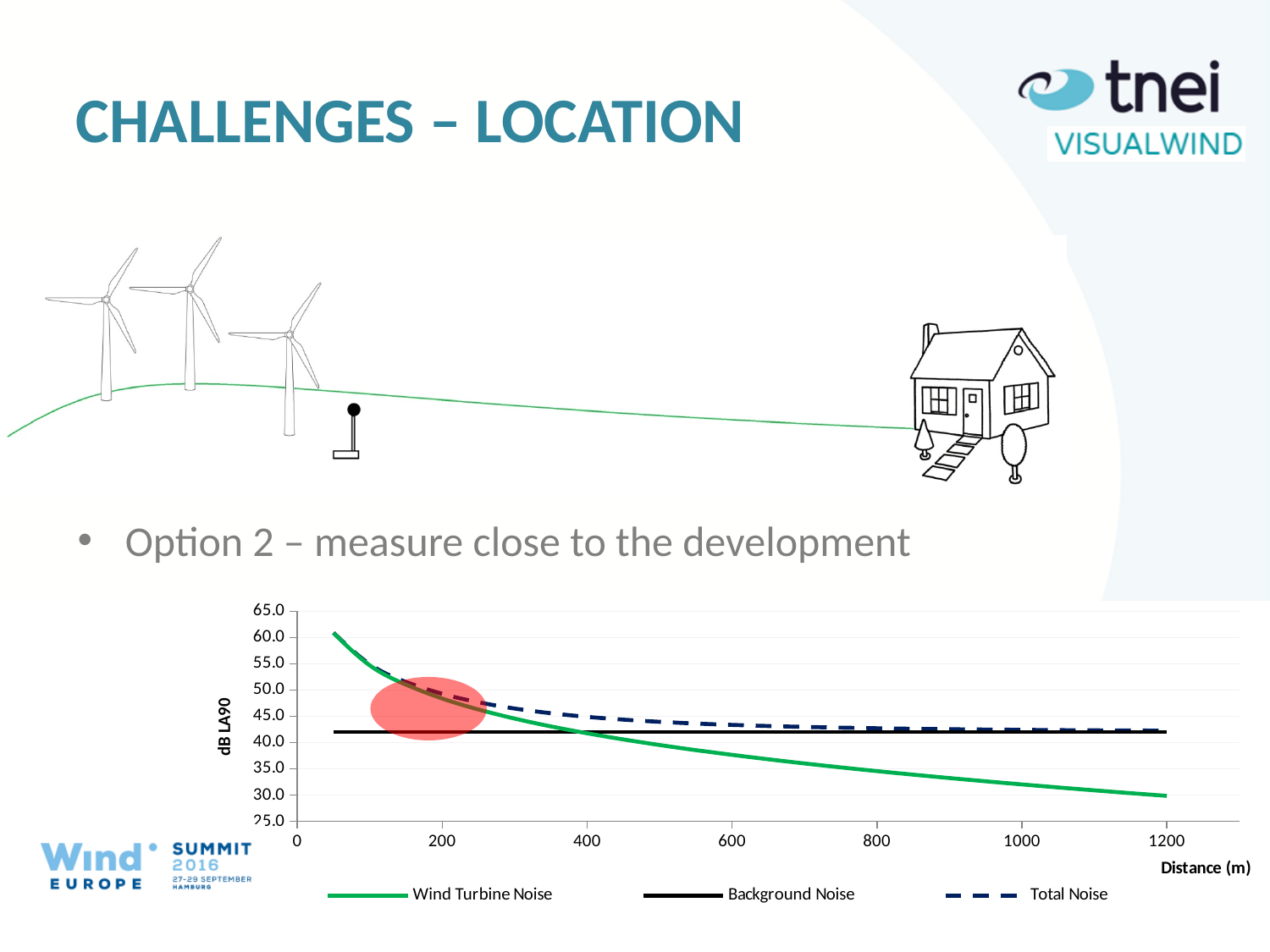
How many series does the chart legend list? 3 Does the Wind Turbine Noise series rise or fall as distance increases? fall Is the Total Noise value at 1200 m greater or less than 45? less Is the Background Noise value greater or less than 40? greater Is the Wind Turbine Noise value at 1200 m greater or less than 35? less At 800 m, which is higher: Total Noise or Wind Turbine Noise? Total Noise What kind of chart is shown on the slide? line chart What is the label of the chart's x axis? Distance (m) What are the three series listed in the chart legend? Wind Turbine Noise, Background Noise, Total Noise At 1200 m, which is higher: Background Noise or Wind Turbine Noise? Background Noise